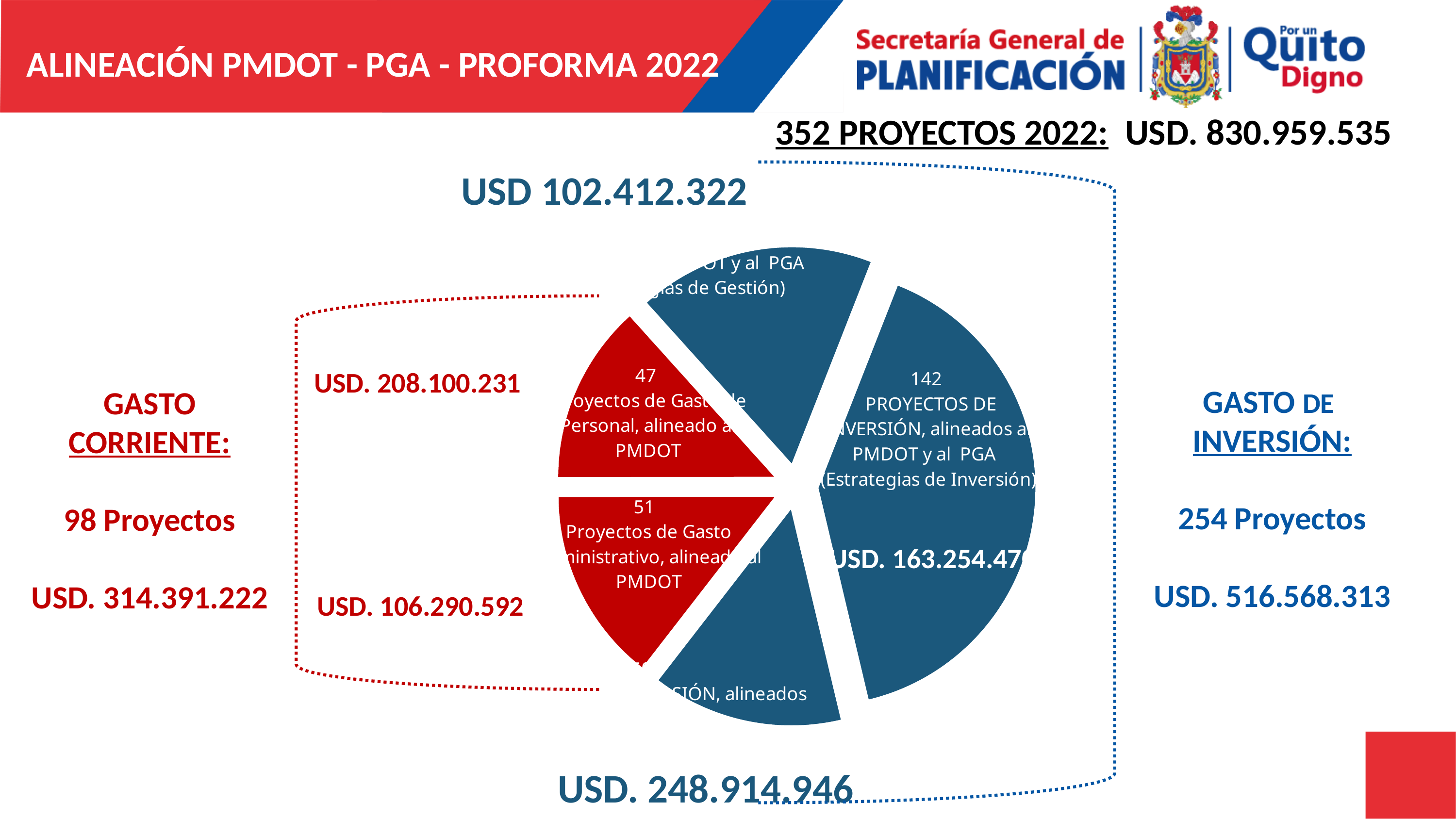
How many slices of the pie chart are coloured red? 2 Which has more projects: Proyectos de Gasto de Personal or Proyectos de Gasto Administrativo? Proyectos de Gasto Administrativo How many slices does the pie chart have? 5 What is the difference between the USD amounts for Gasto de Personal (USD. 208.100.231) and Gasto Administrativo (USD. 106.290.592)? USD. 101.809.639 Which labeled slice has the largest number of projects? 142 PROYECTOS DE INVERSIÓN (Estrategias de Inversión) What kind of chart is shown on the slide? pie chart How many projects are in the slice 'PROYECTOS DE INVERSIÓN, alineados al PMDOT y al PGA (Estrategias de Inversión)'? 142 How many projects are in the slice 'Proyectos de Gasto de Personal, alineado al PMDOT'? 47 What USD amount is shown for the 51 Proyectos de Gasto Administrativo slice? USD. 106.290.592 How many projects are in the slice 'Proyectos de Gasto Administrativo, alineado al PMDOT'? 51 What is the difference in number of projects between the Gasto Administrativo slice (51) and the Gasto de Personal slice (47)? 4 What USD amount is shown for the 47 Proyectos de Gasto de Personal slice? USD. 208.100.231